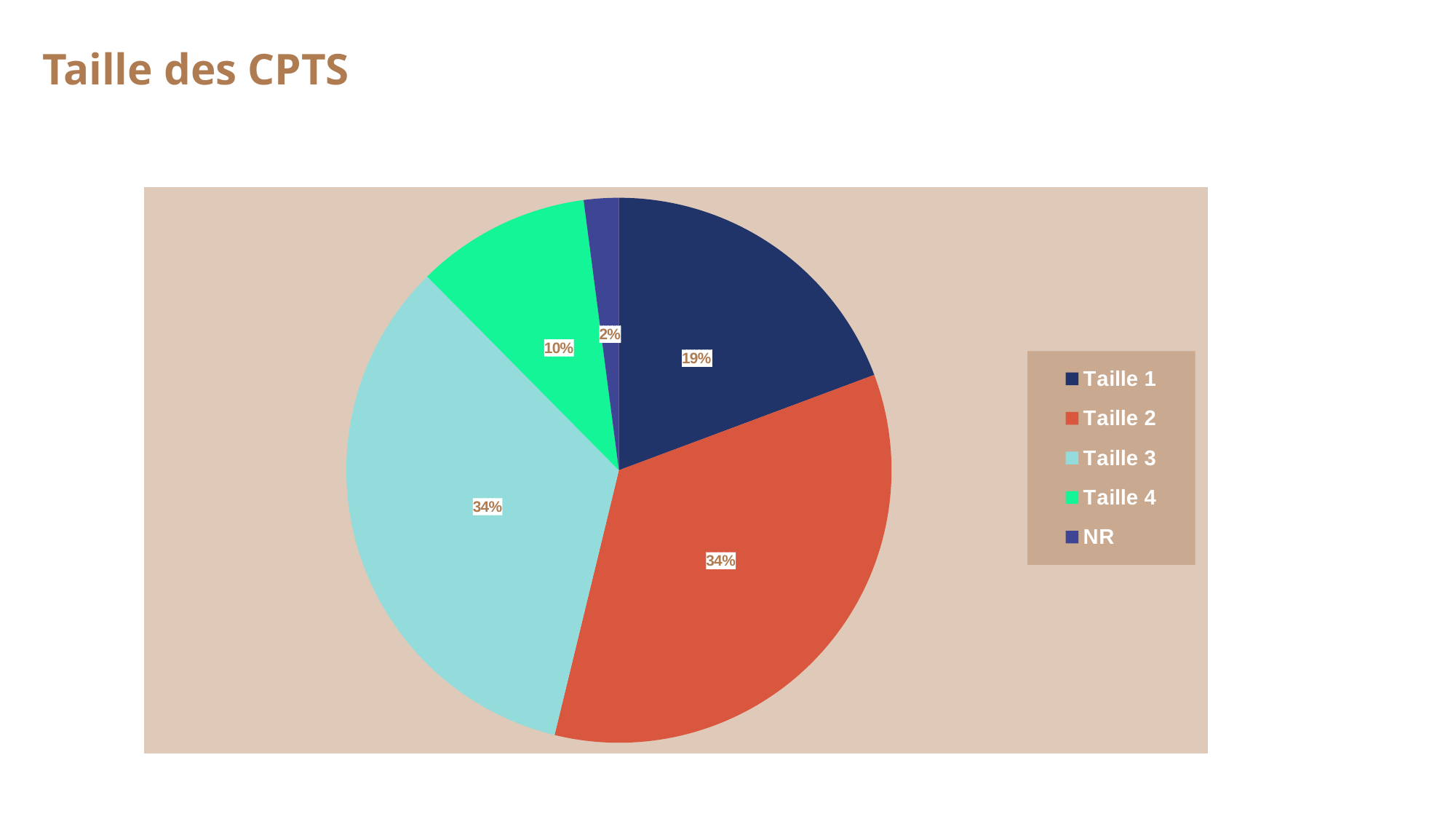
What is the difference in percentage points between the Taille 4 slice and the NR slice? 8 What is the difference in percentage points between the Taille 2 slice and the Taille 1 slice? 15 What share of the pie does NR represent? 2% Which is larger, the slice for Taille 1 or the slice for Taille 4? Taille 1 What kind of chart is shown on the slide? Pie chart How many categories does the pie chart show? 5 What share of the pie does Taille 4 represent? 10% Which category has the smallest slice of the pie? NR What share of the pie does Taille 1 represent? 19% Which is larger, the slice for Taille 3 or the slice for Taille 1? Taille 3 What is the title of the slide? Taille des CPTS